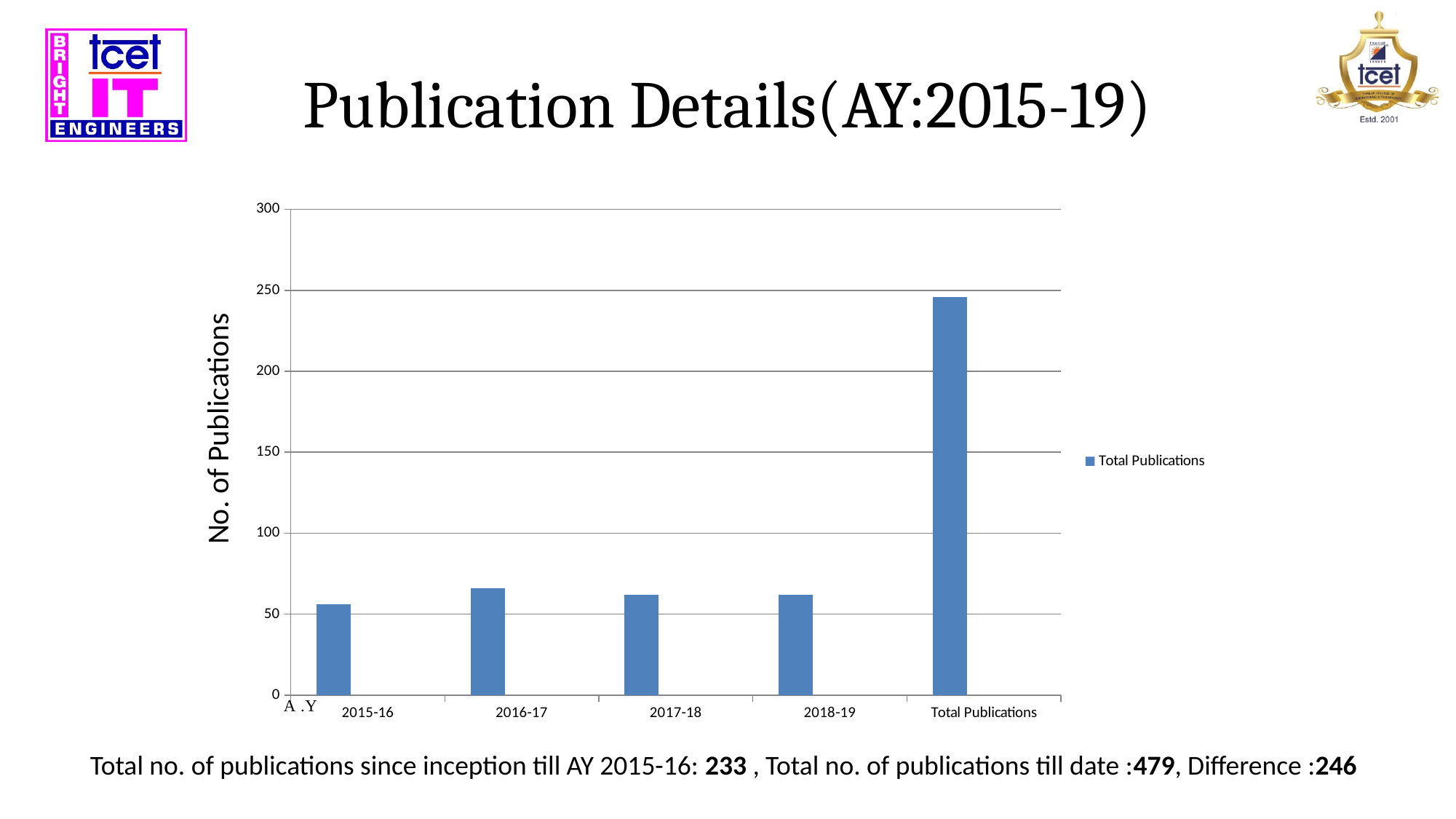
Which has the larger value, 2015-16 or 2016-17? 2016-17 Which category has the highest bar in the chart? Total Publications What kind of chart is shown on the slide? bar chart Which category has the lowest bar in the chart? 2015-16 Is the value for 2016-17 greater or less than 50? greater How many categories are shown on the x axis of the chart? 5 What is the title of the y axis of the chart? No. of Publications How many series does the chart legend list? 1 What series name is shown in the chart legend? Total Publications Is the value for 2015-16 greater or less than 100? less Is the value for 2018-19 greater or less than 100? less